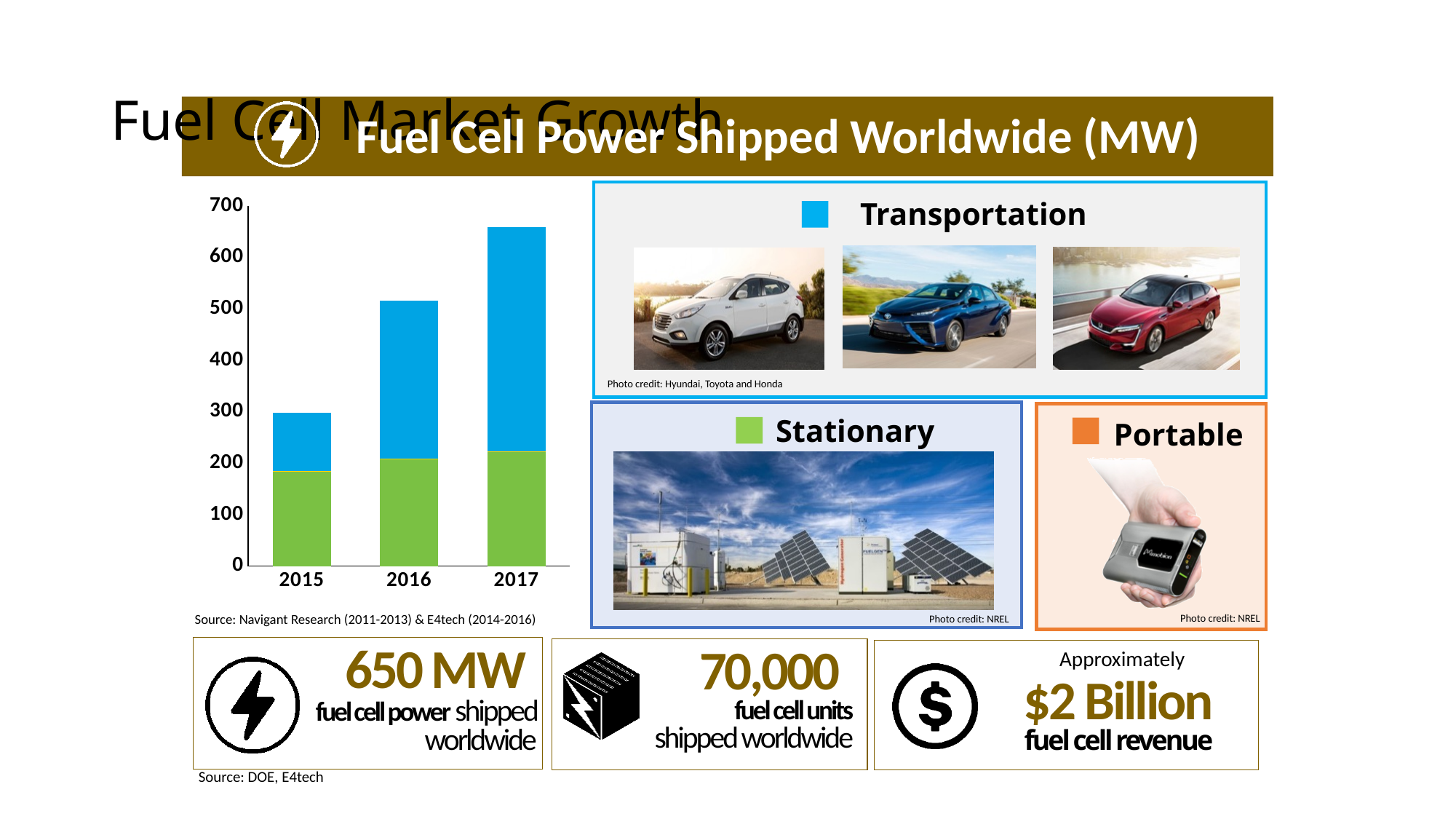
Is the total bar for 2017 greater or less than 600? greater How many years are shown on the x axis of the chart? 3 Which is larger, the total bar for 2016 or the total bar for 2015? 2016 What is the title of the chart? Fuel Cell Power Shipped Worldwide (MW) What kind of chart is shown on the slide? bar chart Which colour represents Transportation in the chart? blue Do the total bar heights rise or fall from 2015 to 2017? rise Is the total bar for 2015 greater or less than 200? greater Which year has the highest total fuel cell power shipped? 2017 Which year has the lowest total fuel cell power shipped? 2015 Is the Stationary segment for 2015 greater or less than 200? less How many series does the chart's legend list? 3